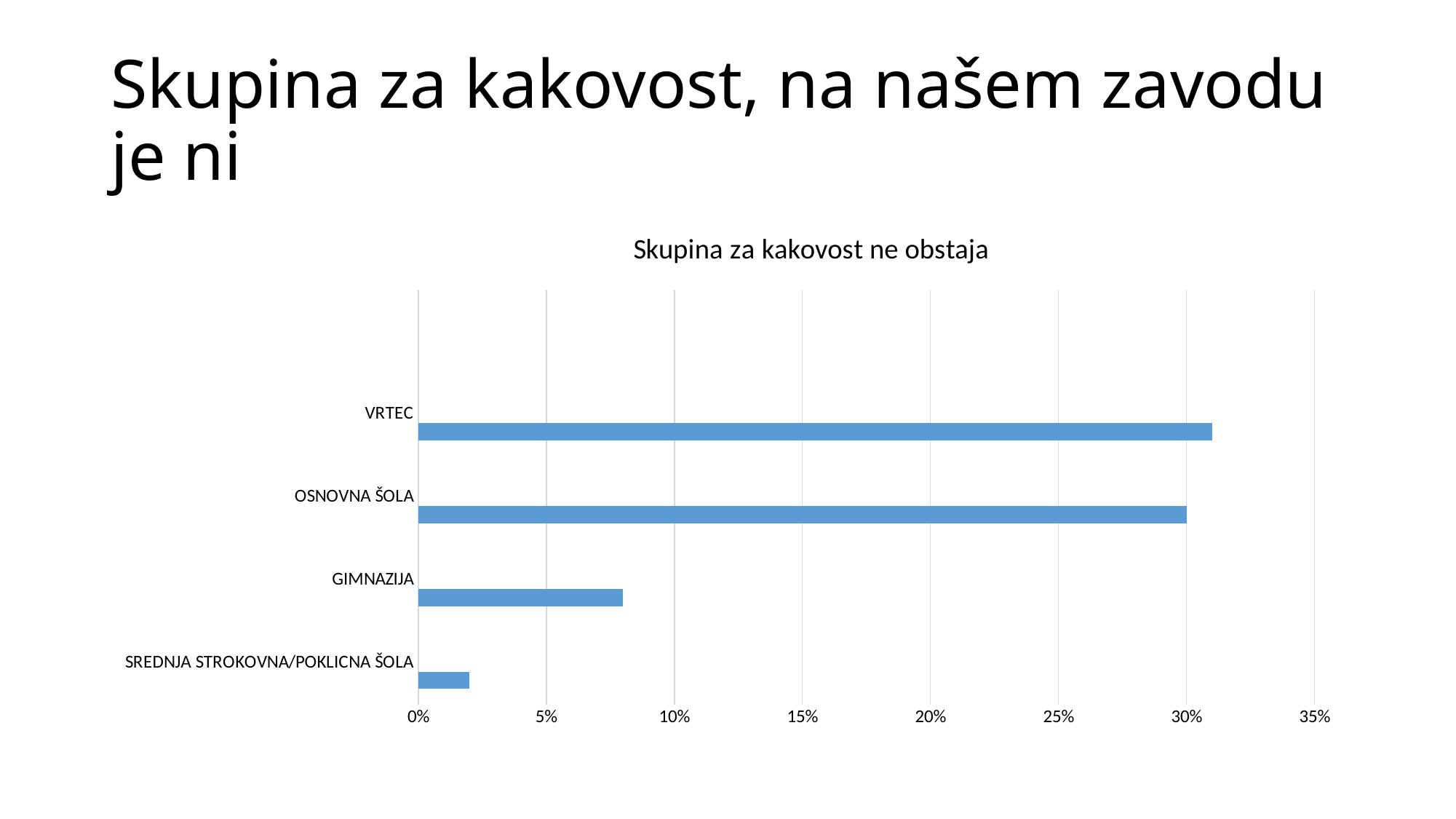
What is the value for OSNOVNA ŠOLA? 30% Is the value for GIMNAZIJA greater or less than 5%? greater What is the title of the chart? Skupina za kakovost ne obstaja Which is larger, the value for OSNOVNA ŠOLA or the value for GIMNAZIJA? OSNOVNA ŠOLA Is the value for VRTEC greater or less than 30%? greater Is the value for GIMNAZIJA greater or less than 10%? less How many categories are shown in the chart? 4 Which is larger, the value for GIMNAZIJA or the value for SREDNJA STROKOVNA/POKLICNA ŠOLA? GIMNAZIJA Which category has the lowest value? SREDNJA STROKOVNA/POKLICNA ŠOLA What is the highest value shown on the horizontal axis? 35% What kind of chart is shown on the slide? bar chart